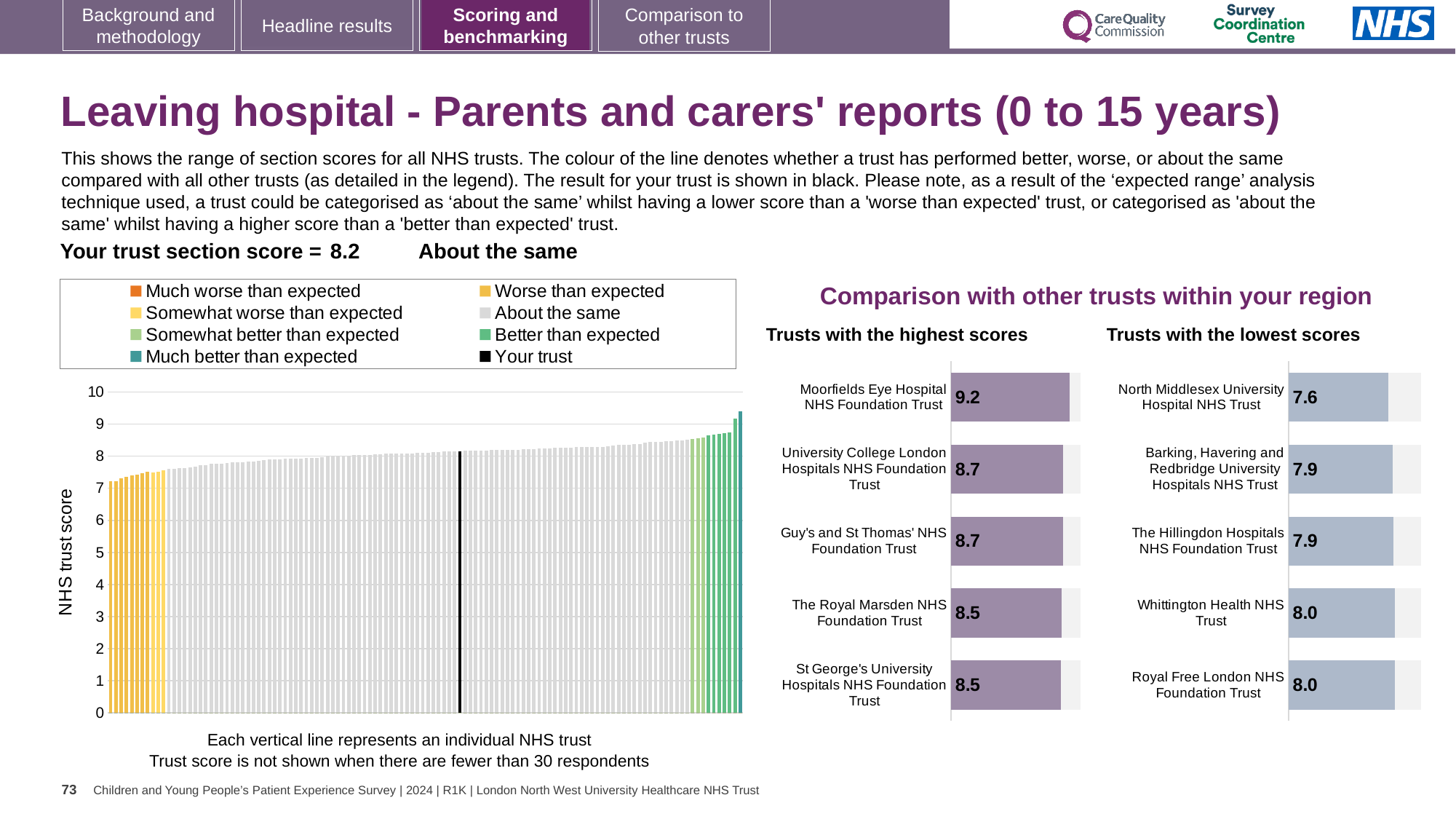
In the large chart on the left showing all NHS trusts, is the value of the leftmost (lowest) bar greater or less than 8? less In the 'Trusts with the highest scores' chart, what is the score for The Royal Marsden NHS Foundation Trust? 8.5 What is the difference between the score for Moorfields Eye Hospital NHS Foundation Trust in the 'Trusts with the highest scores' chart and the score for North Middlesex University Hospital NHS Trust in the 'Trusts with the lowest scores' chart? 1.6 In the 'Trusts with the highest scores' chart, what is the score for Moorfields Eye Hospital NHS Foundation Trust? 9.2 In the 'Trusts with the lowest scores' chart, which trust has the lowest score? North Middlesex University Hospital NHS Trust How many trusts are shown in the 'Trusts with the lowest scores' chart? 5 In the 'Trusts with the highest scores' chart, which trust has the highest score? Moorfields Eye Hospital NHS Foundation Trust In the 'Trusts with the lowest scores' chart, what is the score for Whittington Health NHS Trust? 8.0 In the 'Trusts with the highest scores' chart, which has the larger score: Moorfields Eye Hospital NHS Foundation Trust or The Royal Marsden NHS Foundation Trust? Moorfields Eye Hospital NHS Foundation Trust In the 'Trusts with the lowest scores' chart, what is the score for North Middlesex University Hospital NHS Trust? 7.6 How many entries does the legend of the large chart on the left list? 8 In the large chart on the left showing all NHS trusts, do the values rise or fall from left to right? rise